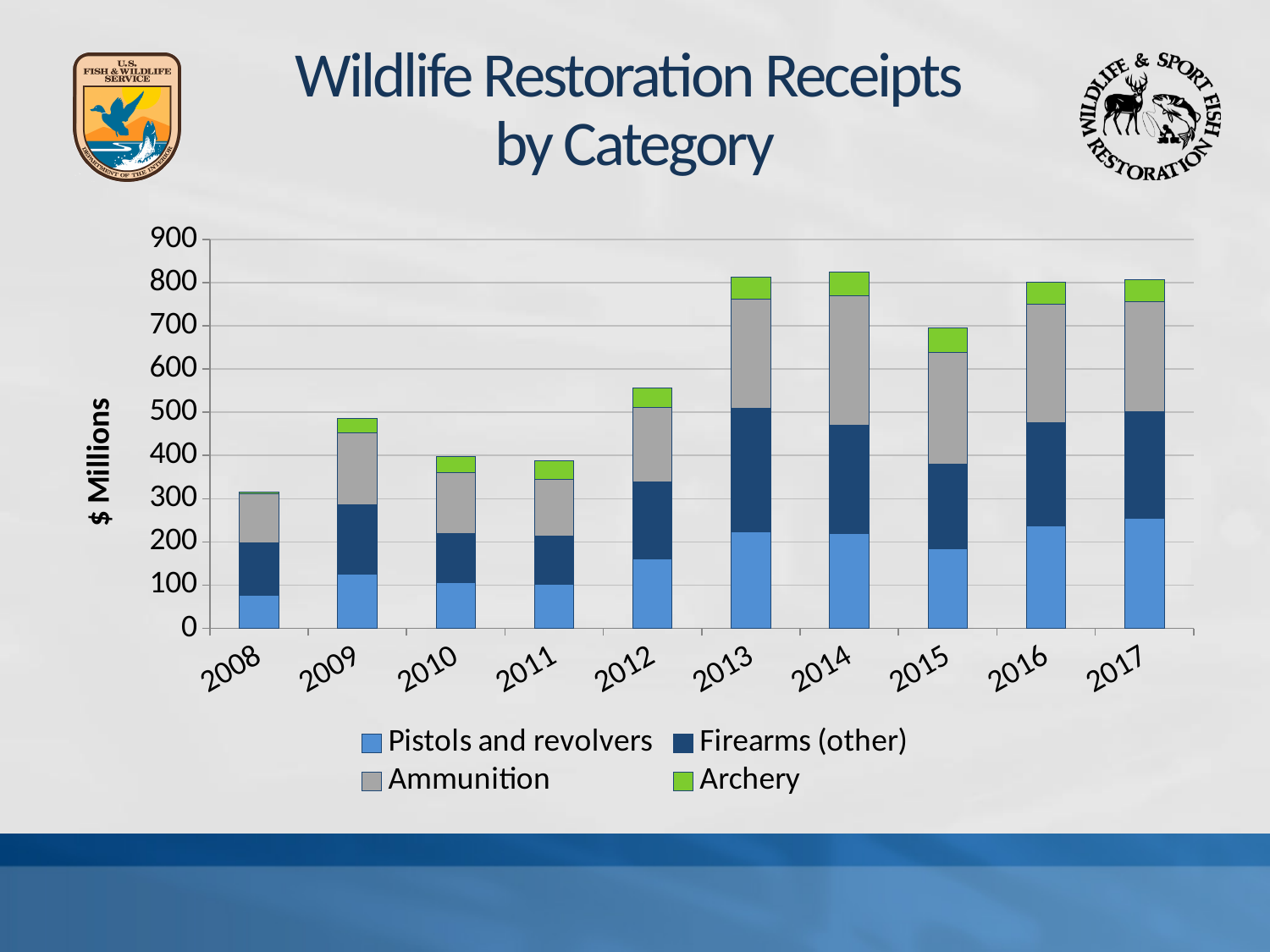
What kind of chart is shown on the slide? Stacked bar chart Which year has larger total receipts, 2012 or 2015? 2015 Is the total receipts value for 2008 greater or less than 400? less Overall, do total receipts rise or fall from 2008 to 2017? rise How many years are shown along the x axis of the chart? 10 Is the total receipts value for 2014 greater or less than 800? greater Which year has larger total receipts, 2009 or 2010? 2009 Is the total receipts value for 2012 greater or less than 500? greater What is the label on the chart's vertical axis? $ Millions How many series does the chart's legend list? 4 Which year has the lowest total receipts in the chart? 2008